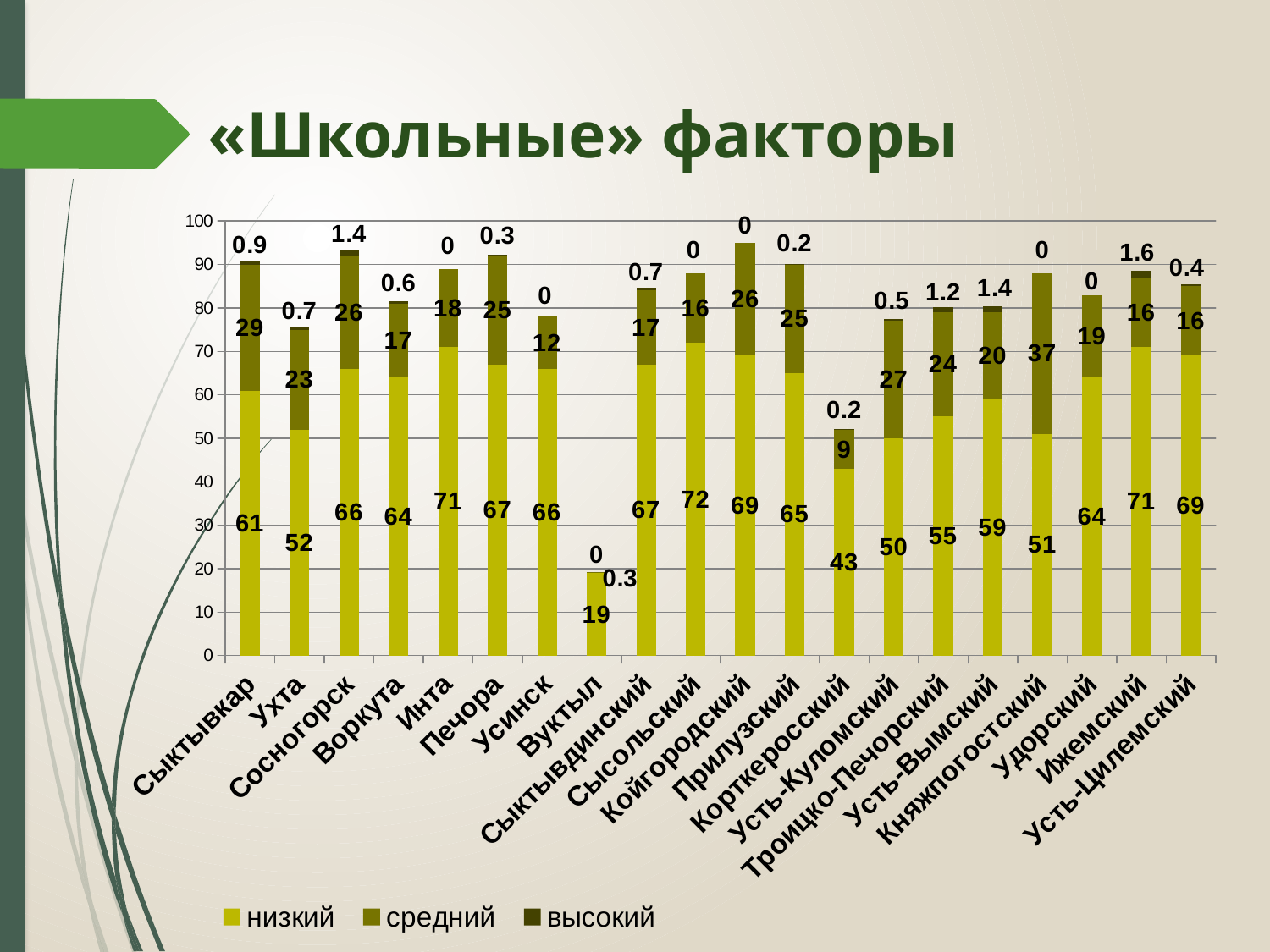
How many categories are shown on the x axis? 20 Which is larger: the средний value for Сосногорск or for Воркута? Сосногорск What is the difference between the низкий values for Инта and Ухта? 19 What is the value of the средний series for Княжпогостский? 37 Which category has the highest value in the средний series? Княжпогостский What kind of chart is shown on the slide? Stacked bar chart What is the value of the высокий series for Ижемский? 1.6 Which category has the lowest value in the низкий series? Вуктыл Which category has the highest value in the низкий series? Сысольский How many series does the legend list? 3 What is the value of the низкий series for Сыктывкар? 61 What is the total of the stacked bar for Сыктывкар? 90.9